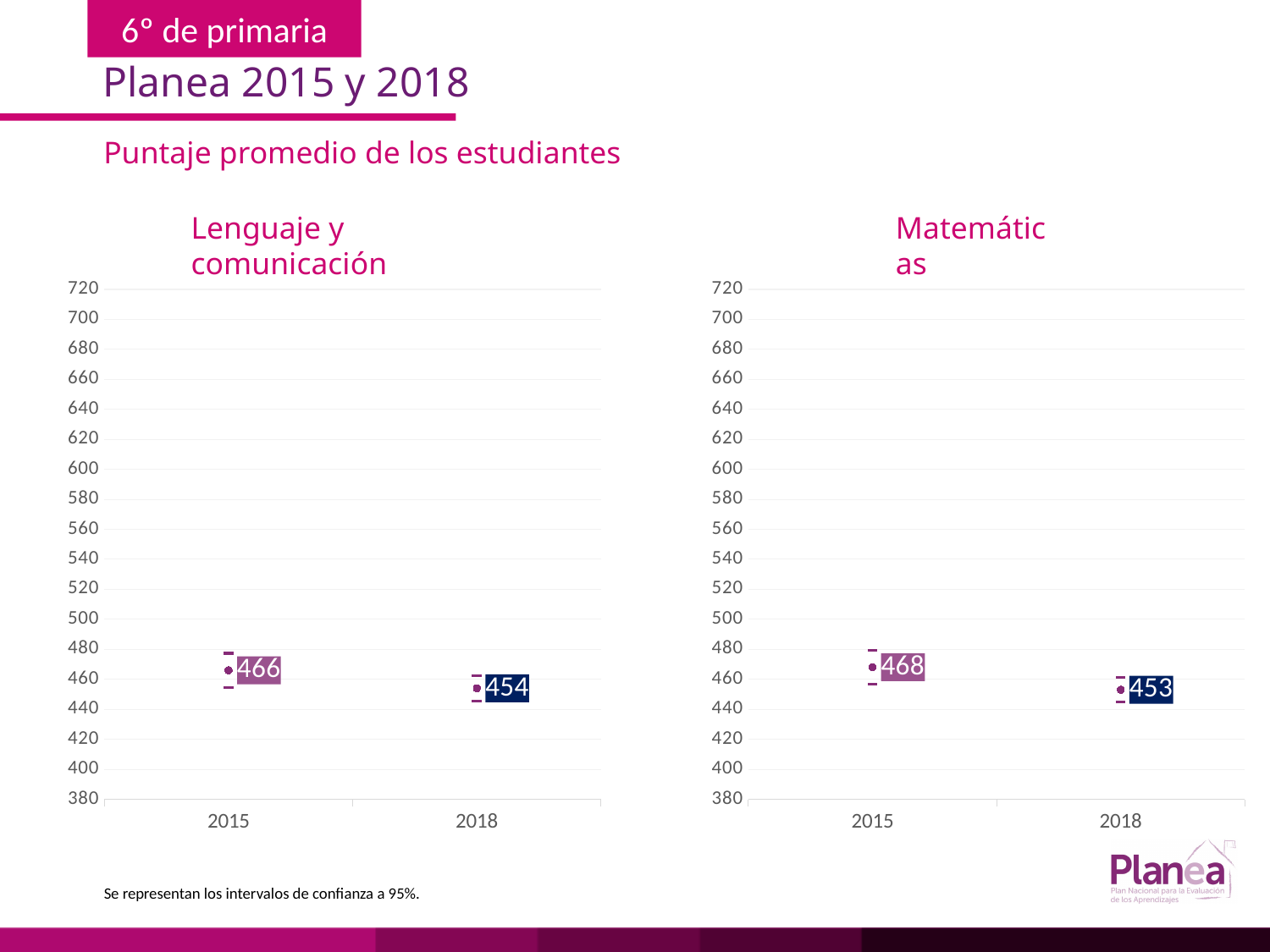
What is the title of the chart on the right side of the slide? Matemáticas How many years are plotted on the x axis of the 'Lenguaje y comunicación' chart? 2 In the 'Lenguaje y comunicación' chart, what is the difference between the 2015 and 2018 values? 12 In the 'Lenguaje y comunicación' chart, what is the value for 2018? 454 In the 'Matemáticas' chart, which year has the higher value, 2015 or 2018? 2015 In the 'Matemáticas' chart, is the value for 2018 greater or less than 460? less In the 'Matemáticas' chart, what is the difference between the 2015 and 2018 values? 15 In the 'Lenguaje y comunicación' chart, what is the value for 2015? 466 In the 'Matemáticas' chart, what is the value for 2015? 468 In the 'Lenguaje y comunicación' chart, do the values rise or fall from 2015 to 2018? fall In the 'Lenguaje y comunicación' chart, which year has the lowest value? 2018 In the 'Matemáticas' chart, what is the value for 2018? 453